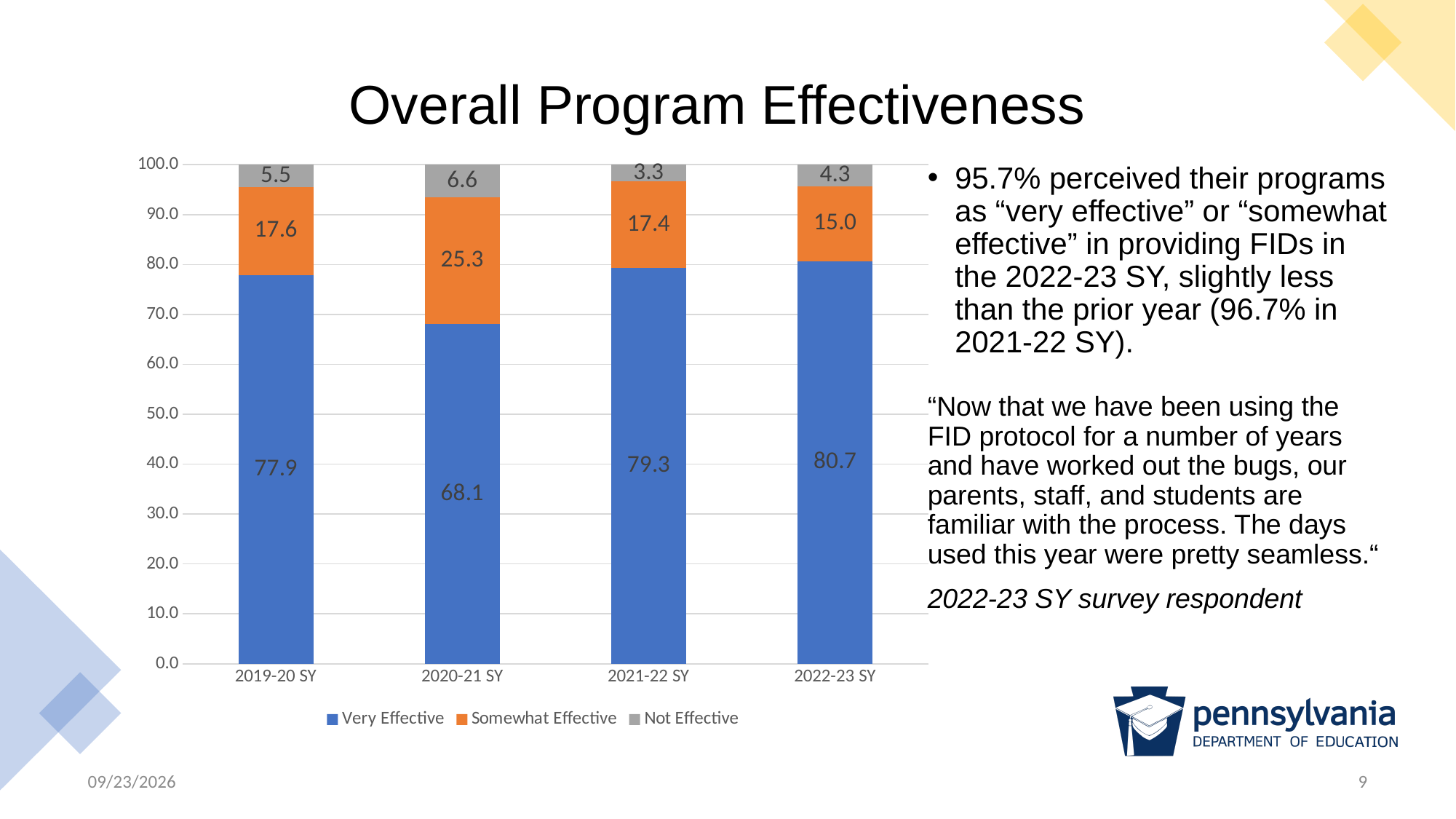
Which is larger, the Somewhat Effective value for 2019-20 SY or for 2020-21 SY? 2020-21 SY What is the difference between the Very Effective values for 2022-23 SY and 2020-21 SY? 12.6 Which school year has the lowest Not Effective value? 2021-22 SY What is the total of the stacked bar for 2022-23 SY? 100.0 What is the Very Effective value for 2020-21 SY? 68.1 What is the title of the chart? Overall Program Effectiveness What kind of chart is shown on the slide? stacked bar chart What is the Somewhat Effective value for 2022-23 SY? 15.0 What is the Not Effective value for 2021-22 SY? 3.3 How many series does the legend list? 3 How many school years are shown on the x axis? 4 Which school year has the highest Very Effective value? 2022-23 SY